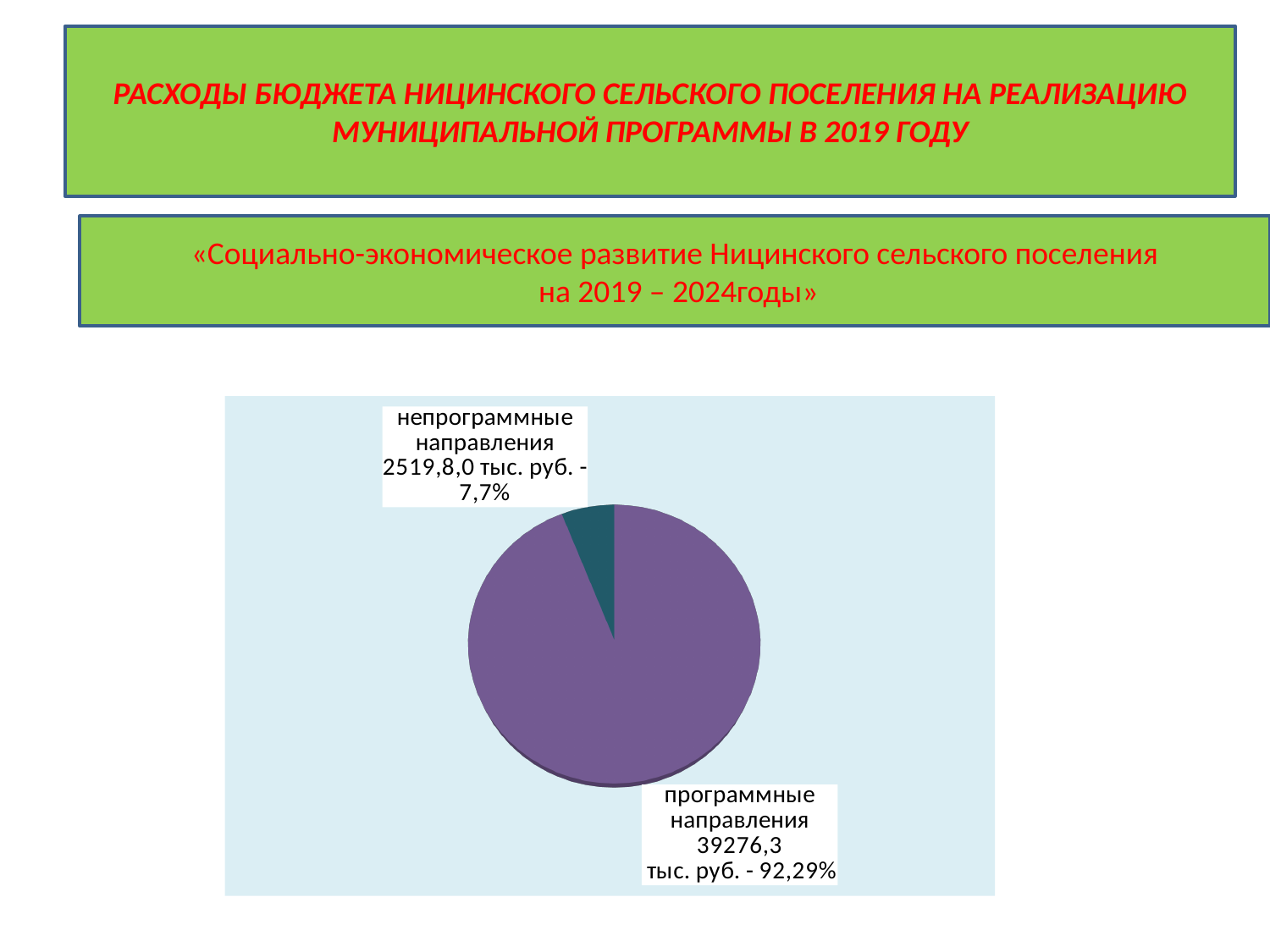
What colour is the slice for «программные направления»? purple Which slice of the pie chart is the largest? программные направления What share of the pie is labelled for «непрограммные направления»? 7,7% What share of the pie is labelled for «программные направления»? 92,29% Which slice of the pie chart is the smallest? непрограммные направления Which is larger: the share for «программные направления» or for «непрограммные направления»? программные направления How many slices does the pie chart have? 2 What kind of chart is shown on the slide? pie chart What is the name of the municipal programme given in the green box above the chart? «Социально-экономическое развитие Ницинского сельского поселения на 2019 – 2024годы» What amount in тыс. руб. is shown for «программные направления»? 39276,3 тыс. руб. What amount in тыс. руб. is shown for «непрограммные направления»? 2519,8,0 тыс. руб. What is the difference in percentage points between the share for «программные направления» (92,29%) and «непрограммные направления» (7,7%)? 84,59%